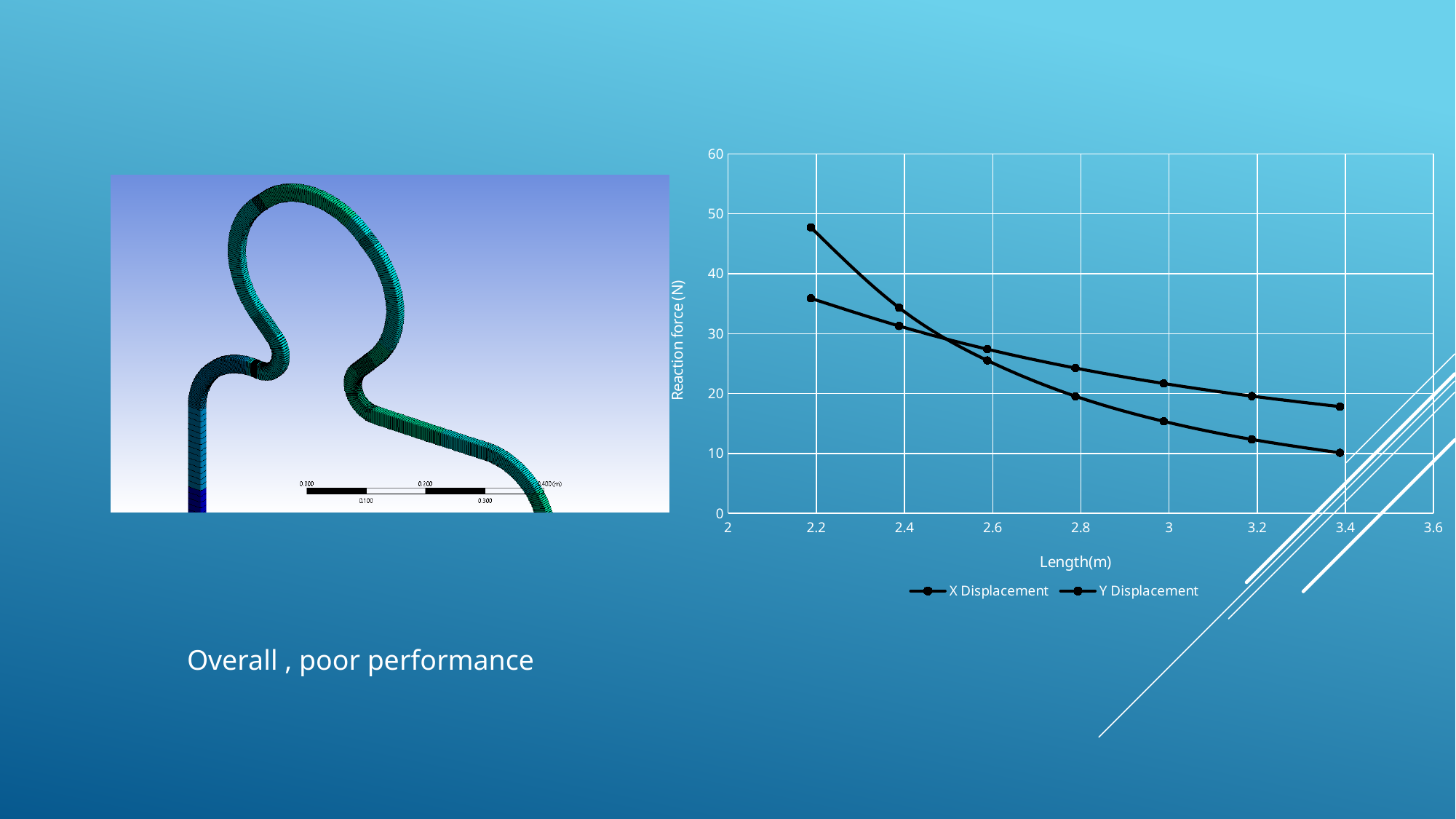
Are both lines' values at the right end of the chart (around Length 3.4) greater or less than 20? less What are the two series named in the chart's legend? X Displacement and Y Displacement Are both lines' values at the left end of the chart (around Length 2.2) greater or less than 30? greater How many series does the chart's legend list? 2 What kind of chart is shown on the slide? Line chart Is the lowest reaction force value plotted on the chart greater or less than 20? less Do the plotted reaction force values rise or fall as Length(m) increases? Fall How many data points are plotted on each line in the chart? 7 What is the title of the chart's vertical axis? Reaction force (N)